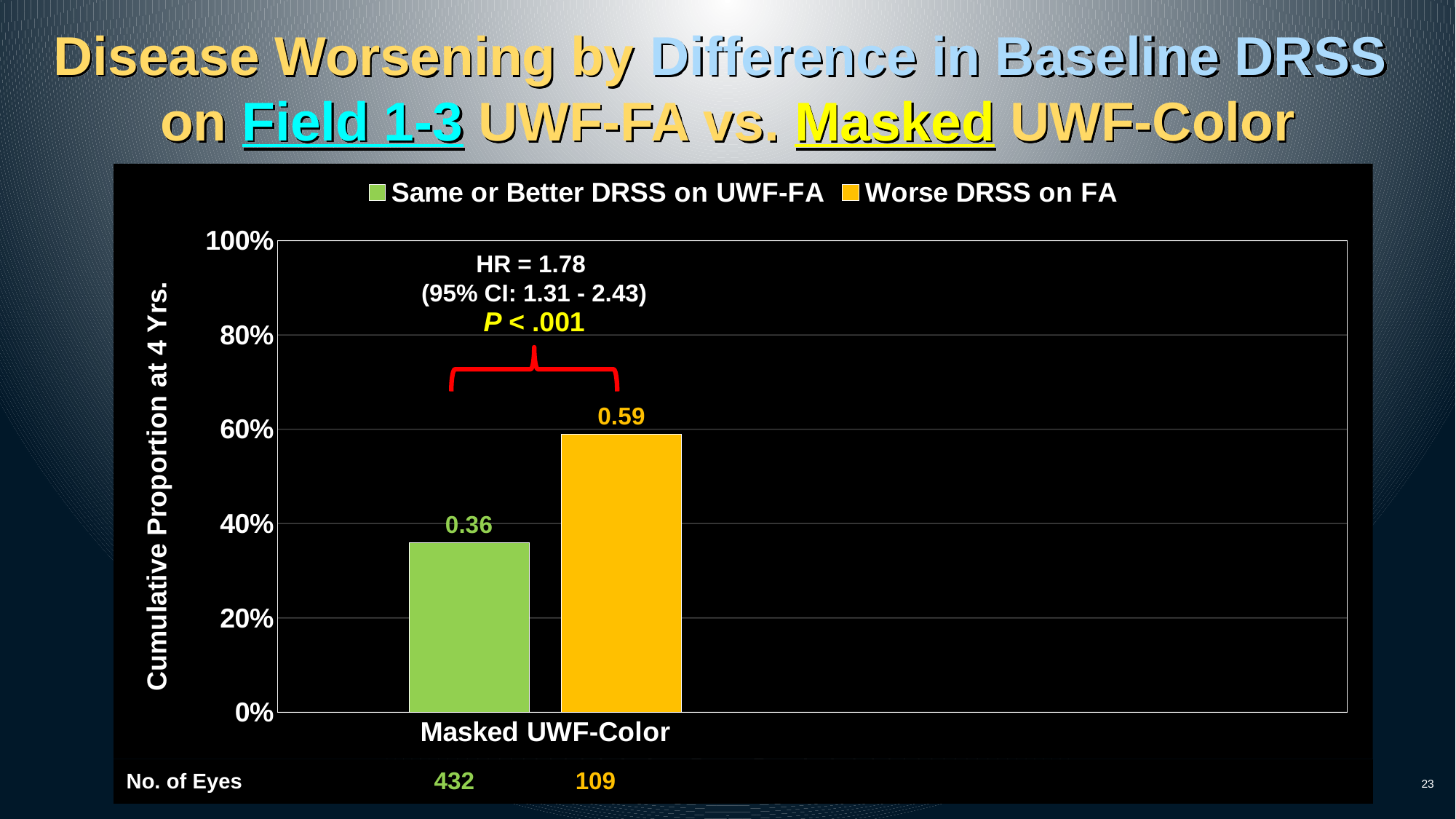
Is the value for Same or Better DRSS on UWF-FA greater or less than 40%? less What is the number of eyes for the Same or Better DRSS on UWF-FA group? 432 How many series does the legend list? 2 What is the value for Worse DRSS on FA? 0.59 Is the value for Worse DRSS on FA greater or less than 40%? greater What kind of chart is shown on the slide? Bar chart What is the difference between the Worse DRSS on FA value and the Same or Better DRSS on UWF-FA value? 0.23 What is the number of eyes for the Worse DRSS on FA group? 109 What is the hazard ratio (HR) shown on the chart? 1.78 What is the value for Same or Better DRSS on UWF-FA? 0.36 What is the y-axis label of the chart? Cumulative Proportion at 4 Yrs. Which series has the higher value, Same or Better DRSS on UWF-FA or Worse DRSS on FA? Worse DRSS on FA